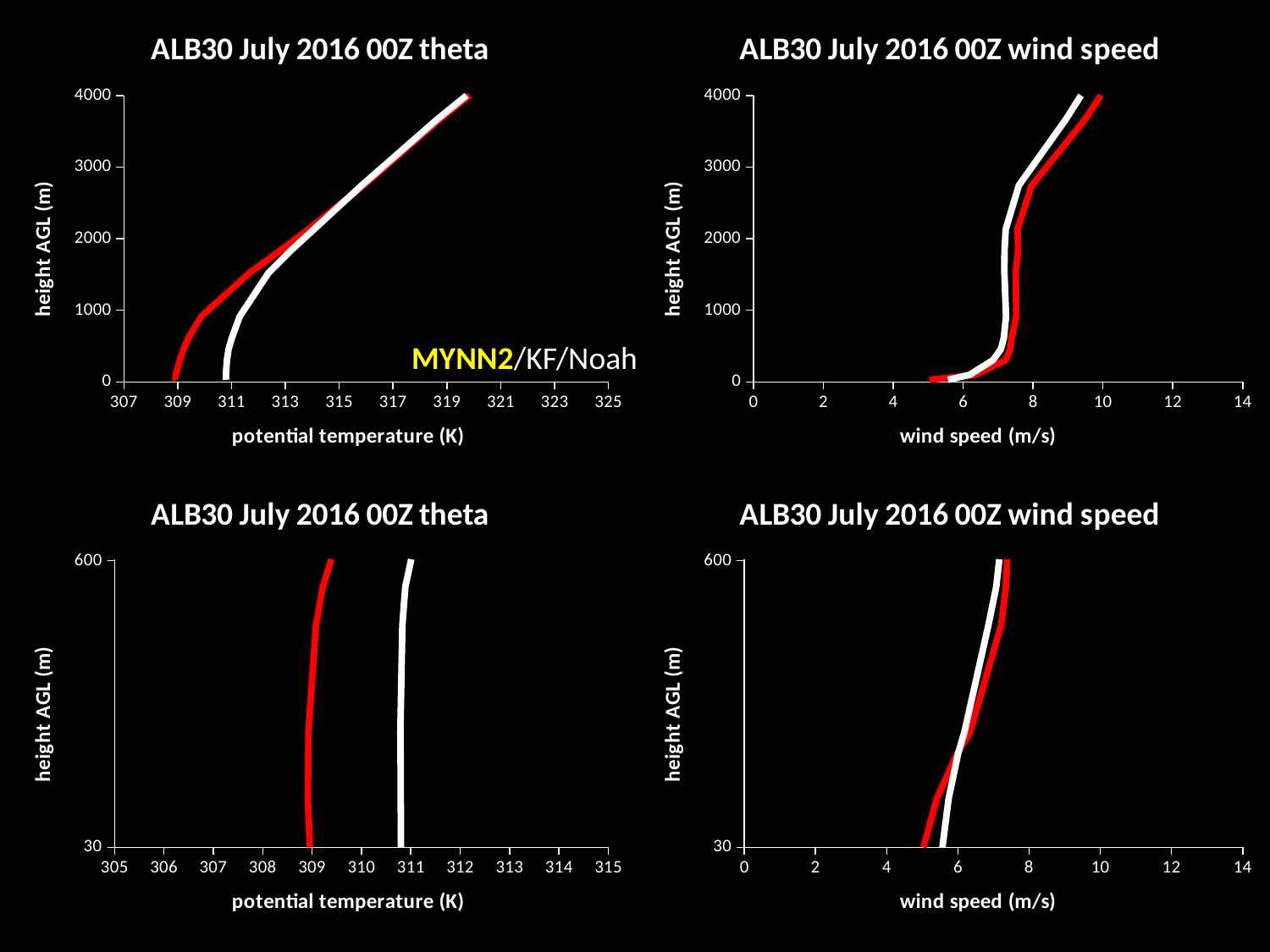
In the bottom-left theta chart, is the potential temperature of the white line at 30 m height greater or less than 310 K? greater In the top-left theta chart, how many lines are plotted? 2 In the top-left theta chart, is the potential temperature of the red line at 0 m height greater or less than 311 K? less In the top-right wind speed chart, is the wind speed of the red line at 0 m height greater or less than 6 m/s? less What kind of chart is the top-left chart titled 'ALB30 July 2016 00Z theta'? line chart What is the x-axis label of the top-right chart? wind speed (m/s) In the top-left theta chart, does potential temperature rise or fall as height AGL increases from 0 to 4000 m? rise In the bottom-left theta chart, which line shows the higher potential temperature at 30 m height, the red line or the white line? white line How many charts are shown on the slide? 4